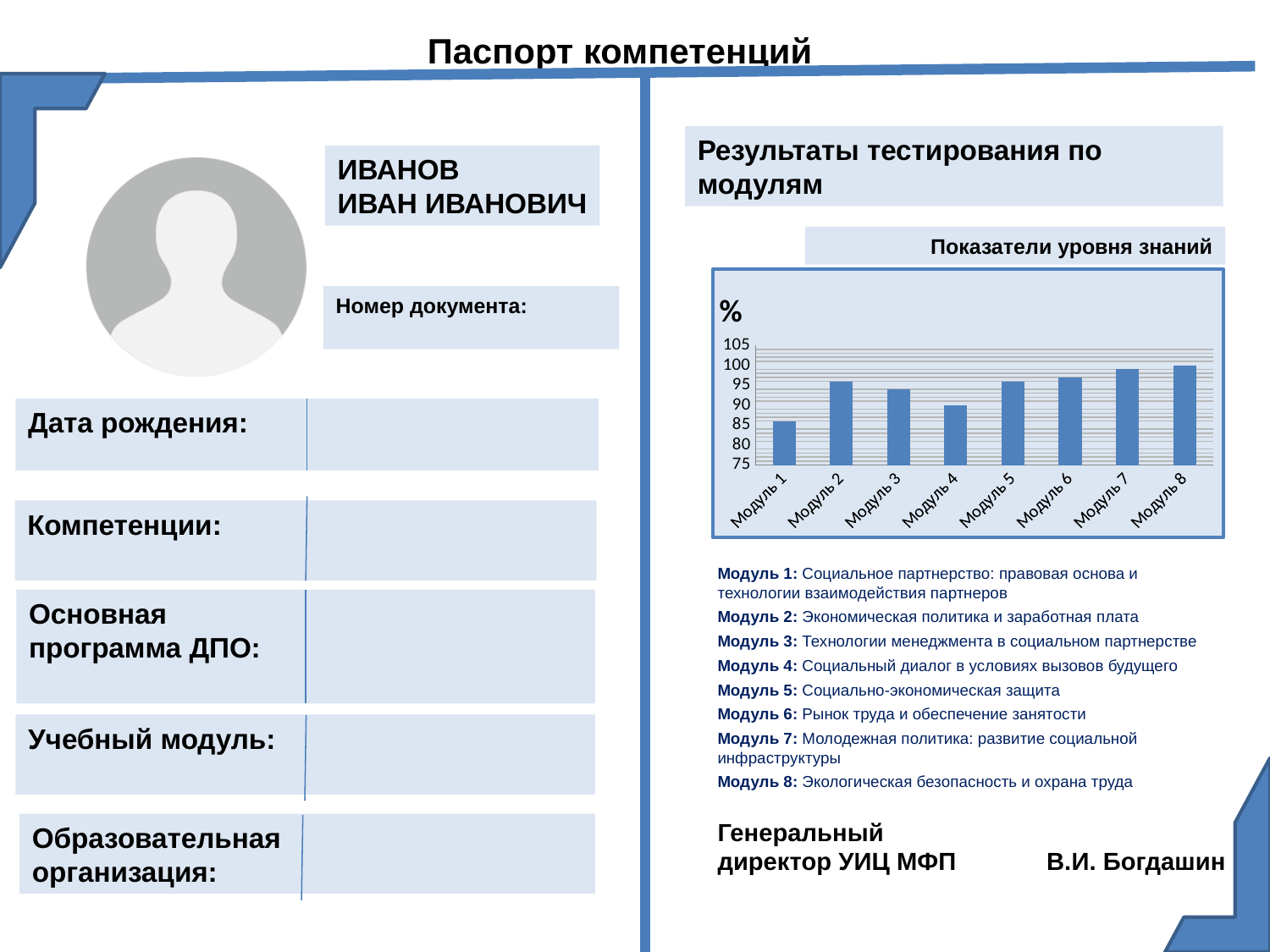
From Модуль 4 to Модуль 8, do the values rise or fall? rise Is the value for Модуль 8 greater or less than 95? greater Is the value for Модуль 1 greater or less than 90? less What kind of chart is shown under "Показатели уровня знаний"? bar chart What is the title of the chart? Показатели уровня знаний Is the value for Модуль 3 greater or less than 90? greater Which is larger, the value for Модуль 2 or the value for Модуль 1? Модуль 2 Which module has the lowest value in the chart? Модуль 1 How many modules are plotted on the x axis of the chart? 8 Which is larger, the value for Модуль 3 or the value for Модуль 4? Модуль 3